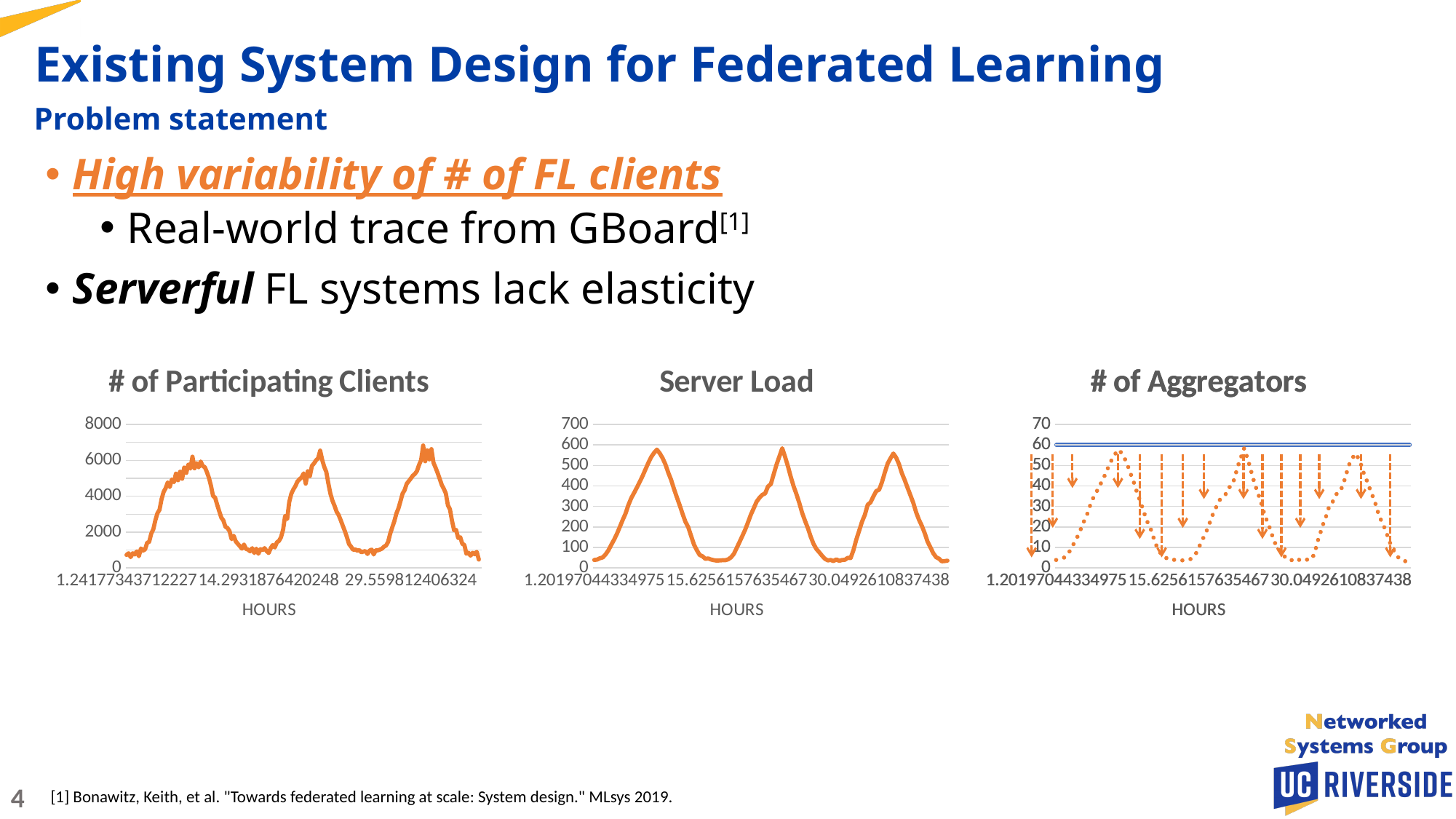
In the '# of Aggregators' chart, is the solid blue line greater or less than 50? greater How many charts are shown on the slide? 3 How many peaks does the orange line in the 'Server Load' chart show? 3 In the '# of Aggregators' chart, does the solid blue line rise, fall, or stay flat along the x axis? stay flat In the '# of Participating Clients' chart, is the highest peak greater or less than 4000? greater What is the x-axis label on the '# of Aggregators' chart? HOURS What kind of chart is the '# of Participating Clients' chart? line chart In the 'Server Load' chart, is the highest peak greater or less than 500? greater What is the title of the middle chart? Server Load